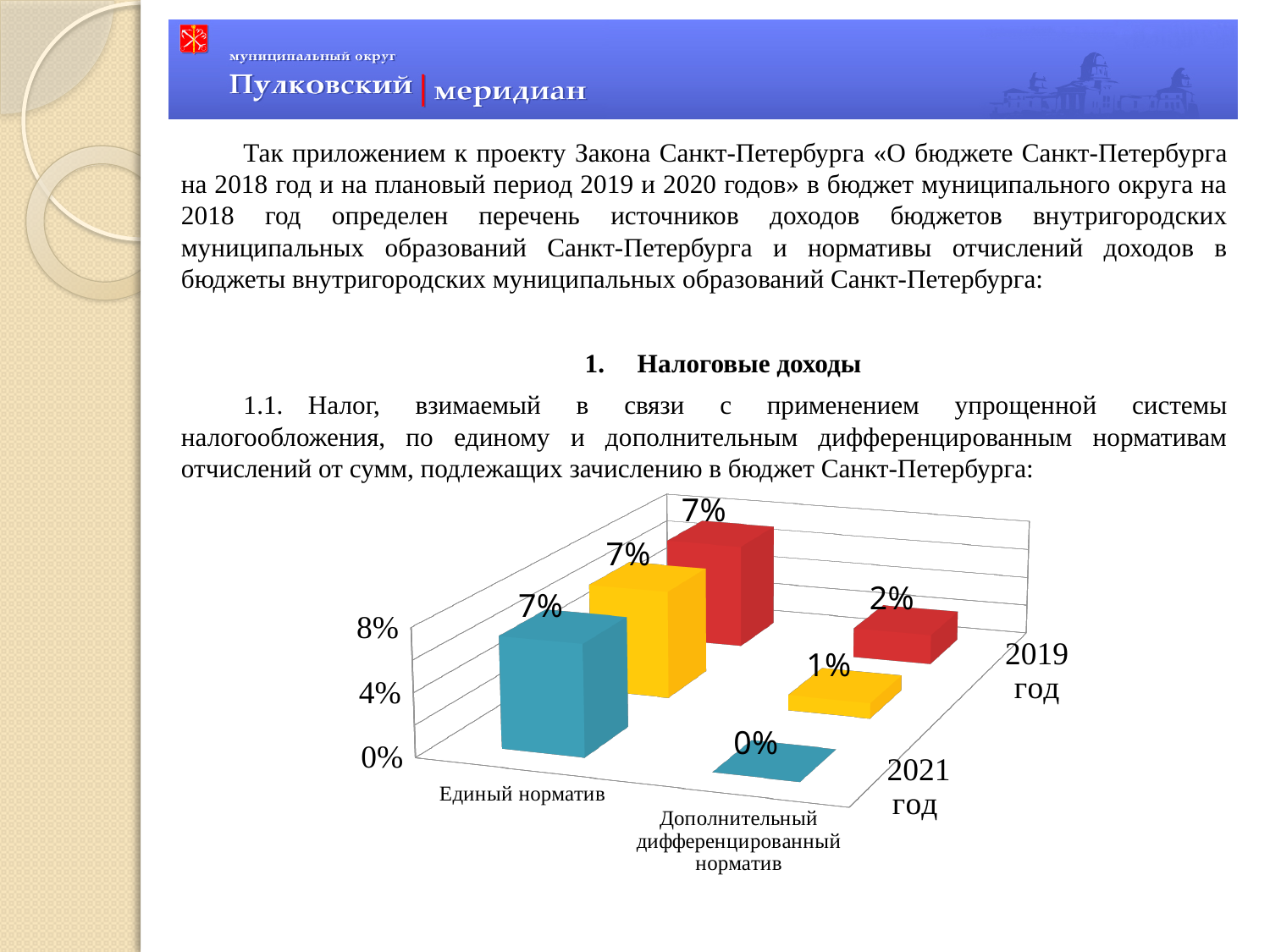
Does the value for Дополнительный дифференцированный норматив rise or fall from 2019 год to 2021 год? fall What is the value for Дополнительный дифференцированный норматив in 2019 год? 2% What is the value for Дополнительный дифференцированный норматив in 2021 год? 0% In 2019 год, which is larger: Единый норматив or Дополнительный дифференцированный норматив? Единый норматив How many categories are shown on the category axis of the chart? 2 Is the value for Единый норматив in 2019 год greater or less than 4%? greater What kind of chart is shown on the slide? bar chart Which category has the lowest value in 2021 год? Дополнительный дифференцированный норматив What is the value for Единый норматив in 2019 год? 7% What is the difference between the 2019 год and 2021 год values for Дополнительный дифференцированный норматив? 2% What is the value for Единый норматив in 2021 год? 7% What is the highest value shown on the vertical axis of the chart? 8%